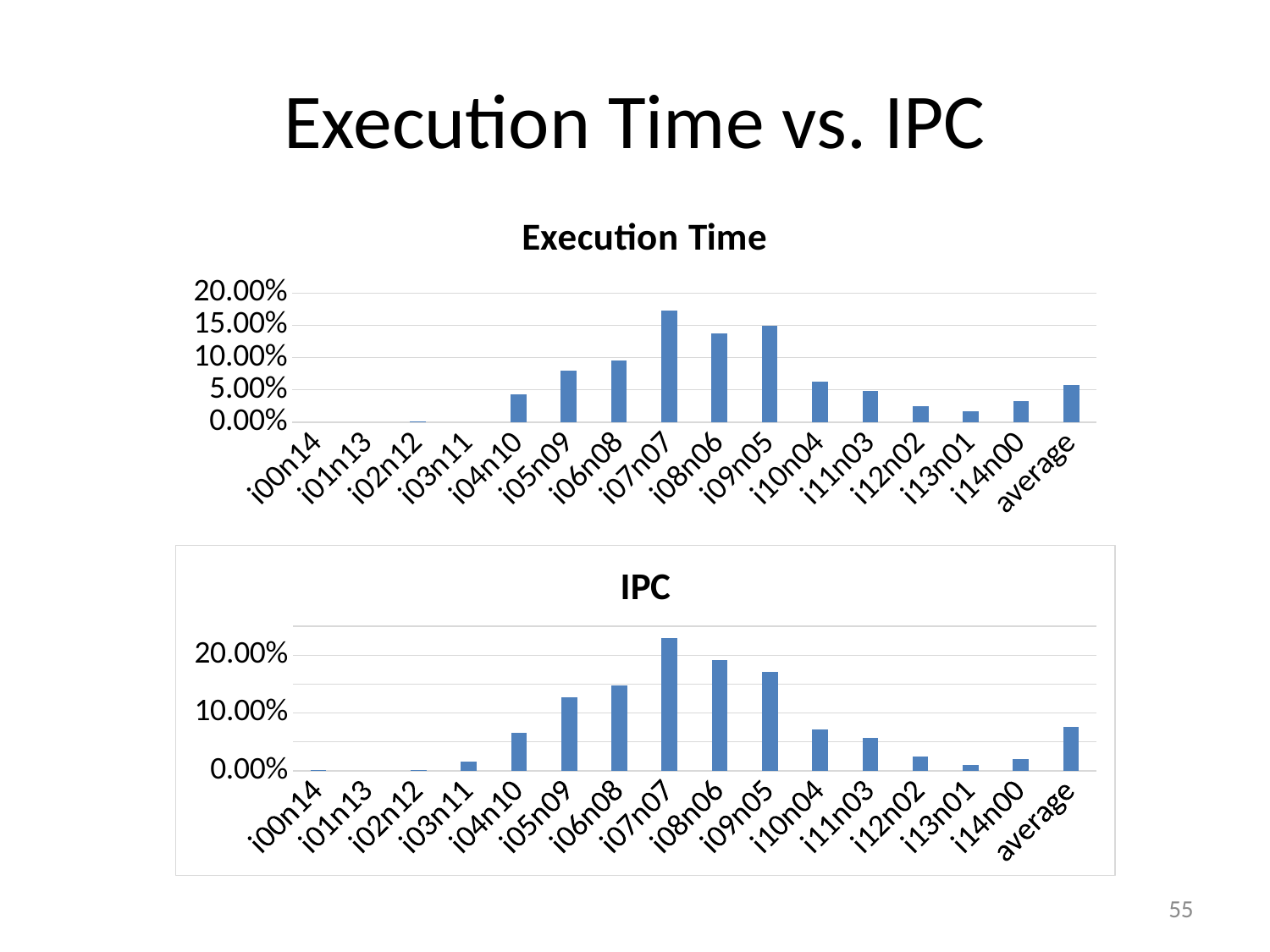
In the Execution Time chart, is the value for i04n10 greater or less than 5.00%? less In the IPC chart, is the value for i07n07 greater or less than 20.00%? greater In the Execution Time chart, which category has the highest value? i07n07 In the Execution Time chart, is the value for i08n06 greater or less than 10.00%? greater What kind of chart is the Execution Time chart? bar chart In the IPC chart, which is larger, the value for i07n07 or the value for i08n06? i07n07 How many categories are shown on the x axis of the IPC chart? 16 In the Execution Time chart, which is larger, the value for i10n04 or the value for i13n01? i10n04 In the IPC chart, which category has the highest value? i07n07